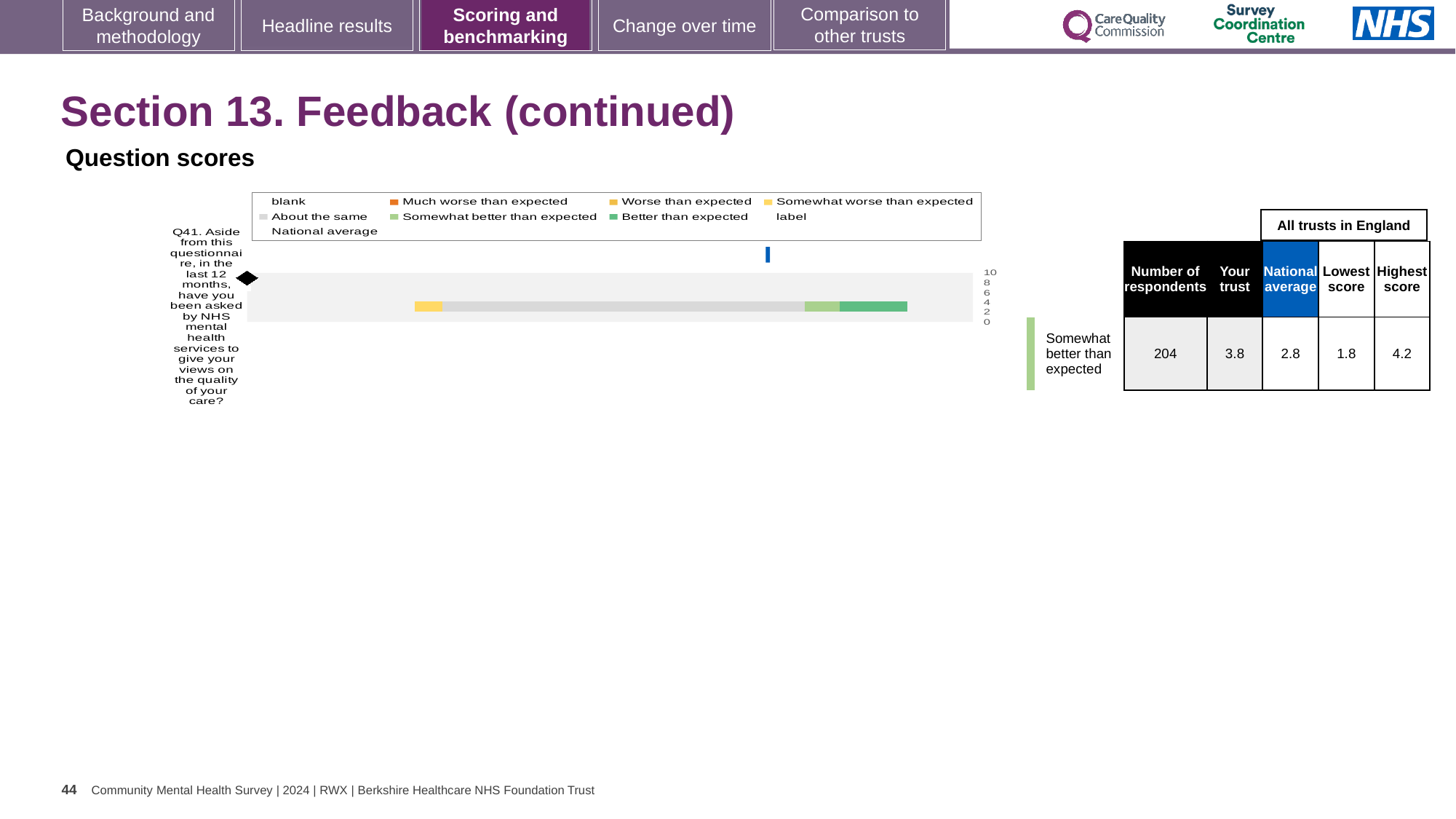
What is the lowest score among all trusts in England for Q41? 1.8 What is the 'Your trust' score for Q41? 3.8 What kind of chart is used to show the Q41 question score? bar chart What is the national average score for Q41? 2.8 What is the number of respondents for Q41? 204 Which benchmark category is Q41 rated as? Somewhat better than expected How many survey questions are plotted in the chart? 1 What is the highest score among all trusts in England for Q41? 4.2 Which is larger for Q41, the 'Your trust' score or the national average? Your trust Is the 'Your trust' score for Q41 greater or less than 2? greater What is the difference between the 'Your trust' score and the national average for Q41? 1.0 What is the difference between the highest and lowest scores among all trusts in England for Q41? 2.4